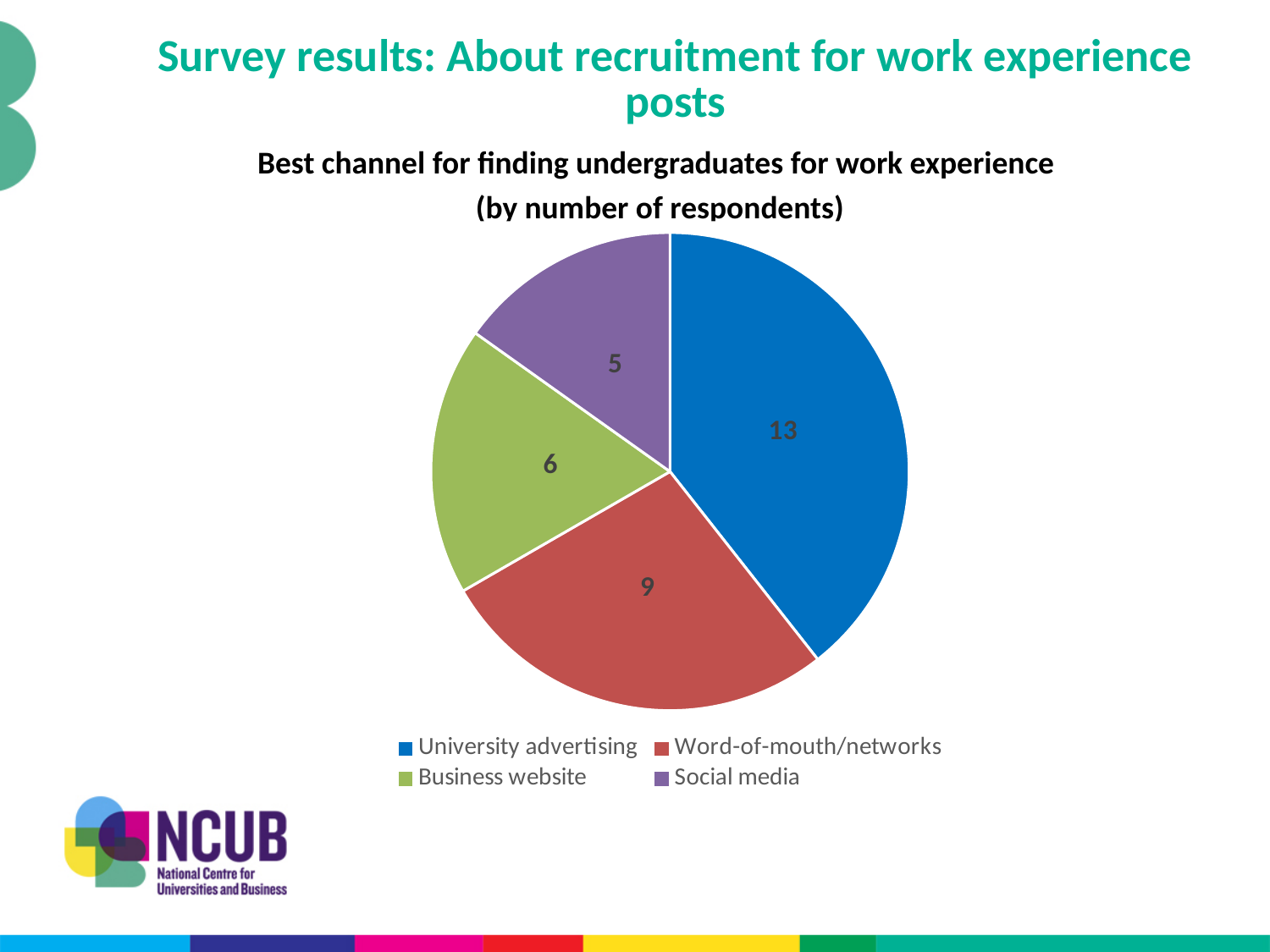
What is the total number of respondents across all slices? 33 Which channel has the lowest number of respondents? Social media What is the title of the chart? Best channel for finding undergraduates for work experience (by number of respondents) Which has more respondents, Business website or Social media? Business website Which channel has the highest number of respondents? University advertising How many respondents chose Word-of-mouth/networks? 9 How many respondents chose Business website? 6 How many slices does the pie chart have? 4 How many respondents chose University advertising as the best channel? 13 How many respondents chose Social media? 5 What is the difference in respondents between University advertising and Word-of-mouth/networks? 4 What type of chart is shown on the slide? pie chart